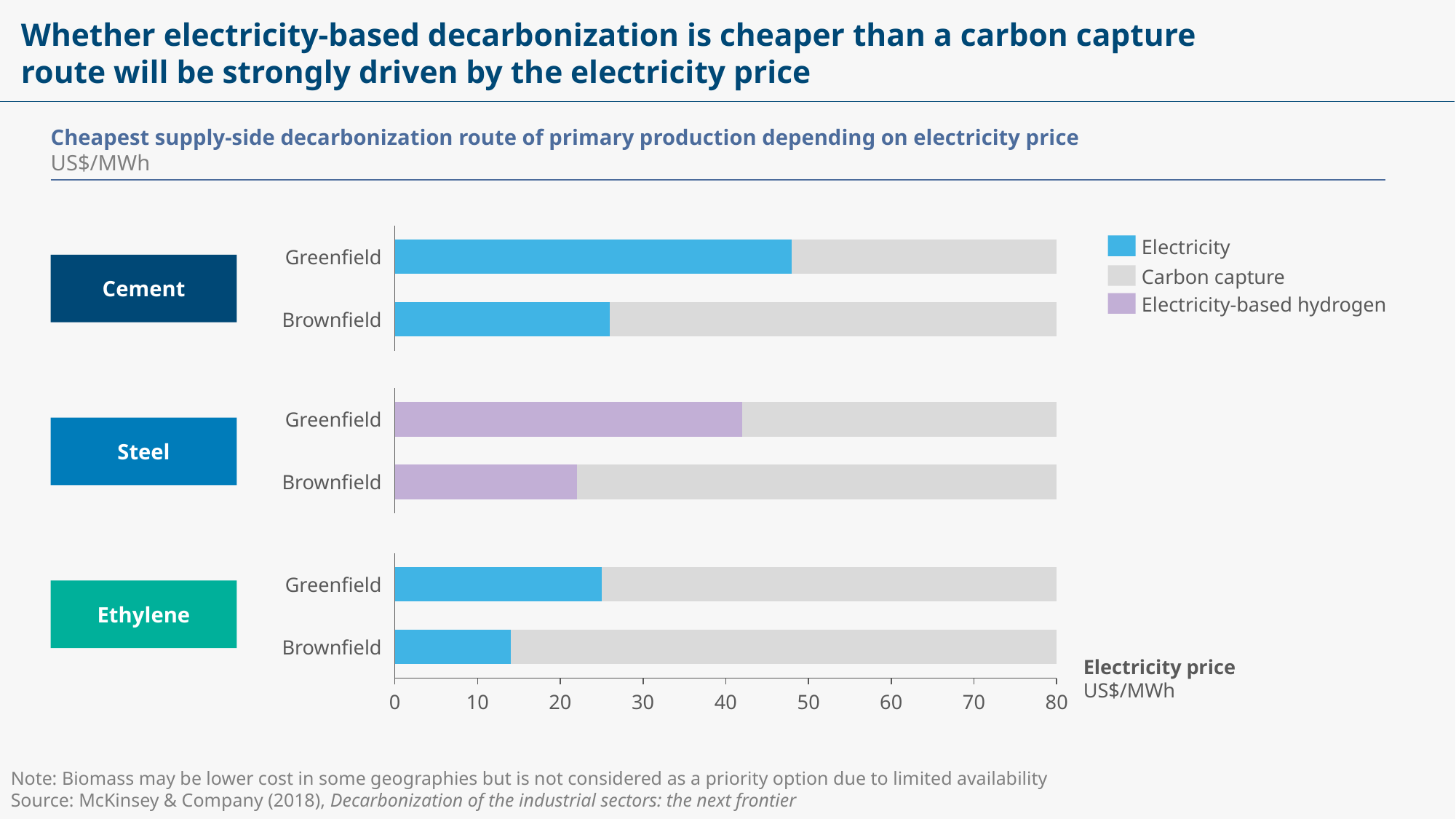
How many bars are plotted in the chart? 6 Which bar has the smallest coloured (non-carbon-capture) segment? Ethylene Brownfield Which has the larger Electricity segment: Cement Greenfield or Ethylene Greenfield? Cement Greenfield Is the Electricity segment for Ethylene Brownfield greater or less than 20 US$/MWh? less Which bar has the largest coloured (non-carbon-capture) segment? Cement Greenfield Which sector's bars use the Electricity-based hydrogen series instead of Electricity? Steel How many series does the legend list? 3 Is the Electricity-based hydrogen segment for Steel Greenfield greater or less than 30 US$/MWh? greater Is the Electricity segment for Cement Greenfield greater or less than 40 US$/MWh? greater What kind of chart is shown on the slide? Bar chart